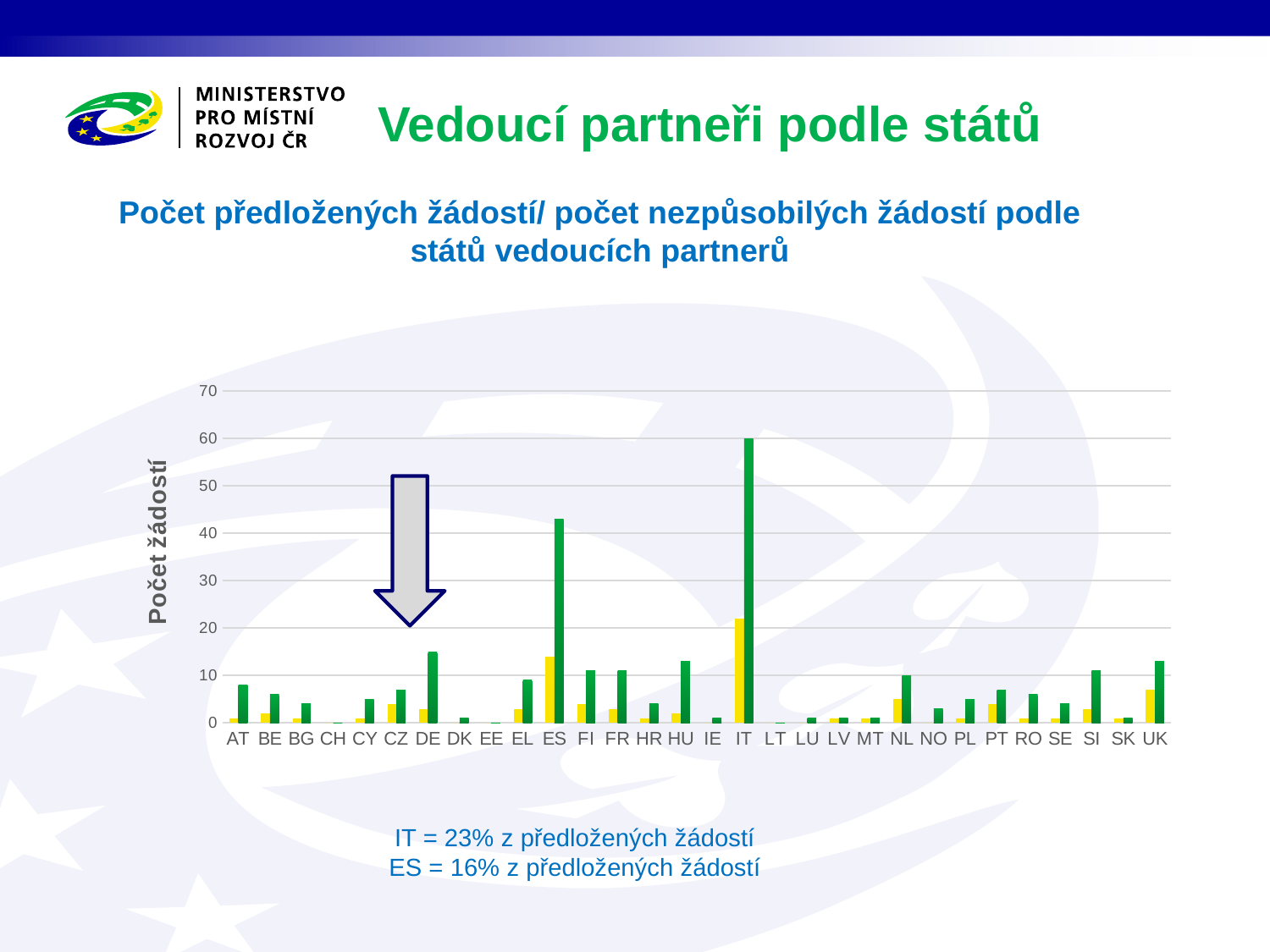
Which has the taller green bar, DE or CZ? DE Which country has the tallest green bar in the chart? IT What is the label on the vertical axis of the chart? Počet žádostí Which country has the tallest yellow bar in the chart? IT Is the green bar for ES greater or less than 40? greater Is the green bar for IT greater or less than 50? greater Which has the taller green bar, IT or ES? IT What kind of chart is shown on the slide? bar chart Is the green bar for CZ greater or less than 10? less How many countries (categories) are shown on the x axis of the chart? 30